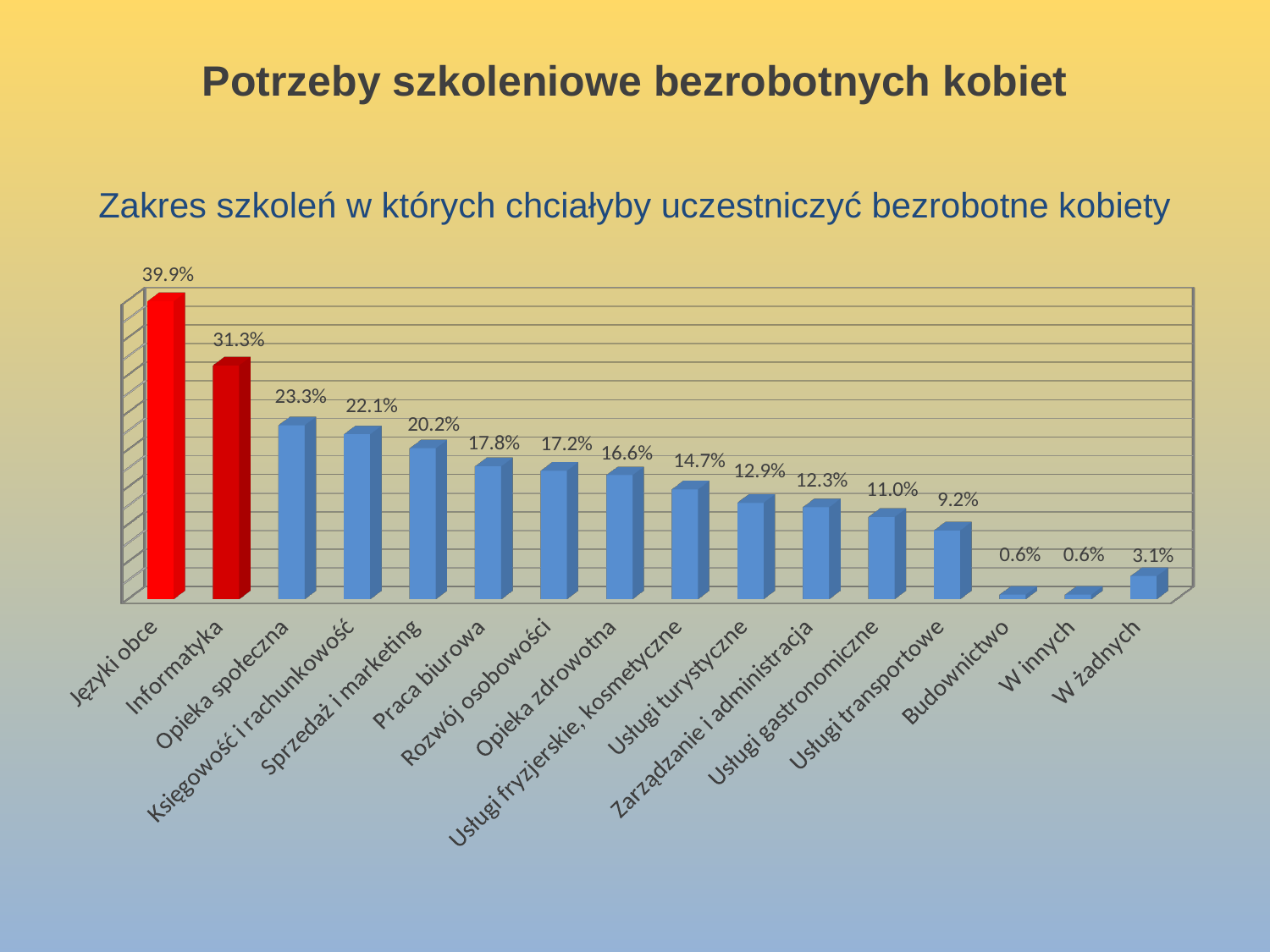
What is the value for Informatyka? 31.3% What kind of chart is shown on the slide? Bar chart What is the value for Języki obce? 39.9% What is the difference between the values for Opieka społeczna and Księgowość i rachunkowość? 1.2% What is the value for W żadnych? 3.1% How many categories are shown on the x axis? 16 Which is larger, the value for W żadnych or the value for Budownictwo? W żadnych What is the difference between the values for Języki obce and Informatyka? 8.6% Which category has the highest value? Języki obce Which is larger, the value for Praca biurowa or the value for Usługi turystyczne? Praca biurowa What is the value for Usługi transportowe? 9.2% Which two categories are shown with red bars? Języki obce and Informatyka